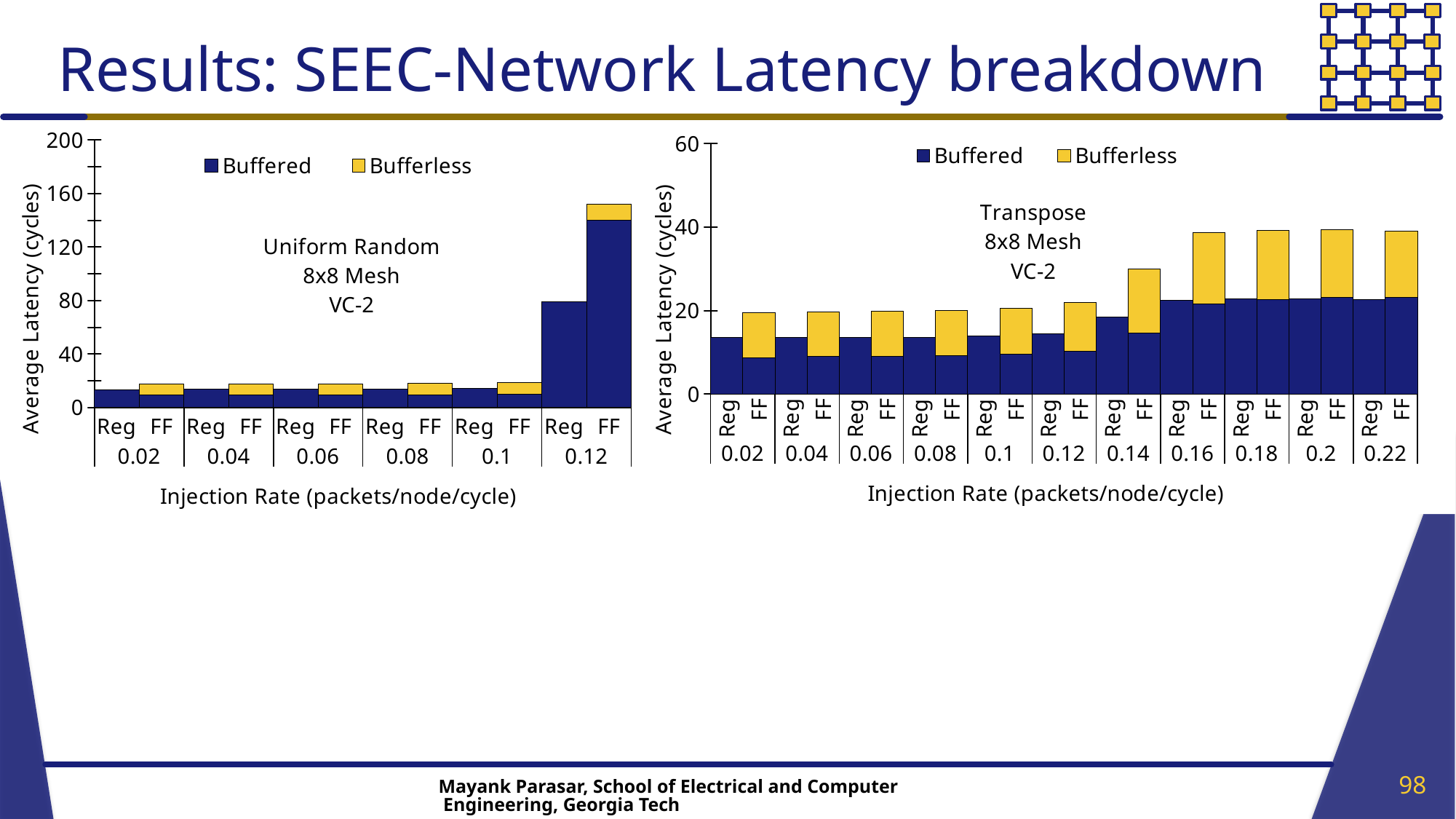
How many injection rates are shown on the x axis of the Uniform Random chart on the left? 6 In the Transpose chart on the right, is the total height of the Reg bar at injection rate 0.02 greater or less than 20? less In the Transpose chart on the right, is the total height of the FF bar at injection rate 0.22 greater or less than 20? greater What are the two legend entries in the Transpose chart on the right? Buffered and Bufferless In the Uniform Random chart on the left, is the total height of the Reg bar at injection rate 0.12 greater or less than 40? greater How many injection rates are shown on the x axis of the Transpose 8x8 Mesh VC-2 chart on the right? 11 In the Transpose chart on the right, do the Reg bars generally rise or fall as the injection rate increases? rise How many series does the legend of the Uniform Random chart on the left list? 2 In the Uniform Random chart on the left, at which injection rate is the FF bar tallest? 0.12 What kind of chart is the Uniform Random 8x8 Mesh VC-2 chart on the left? Bar chart